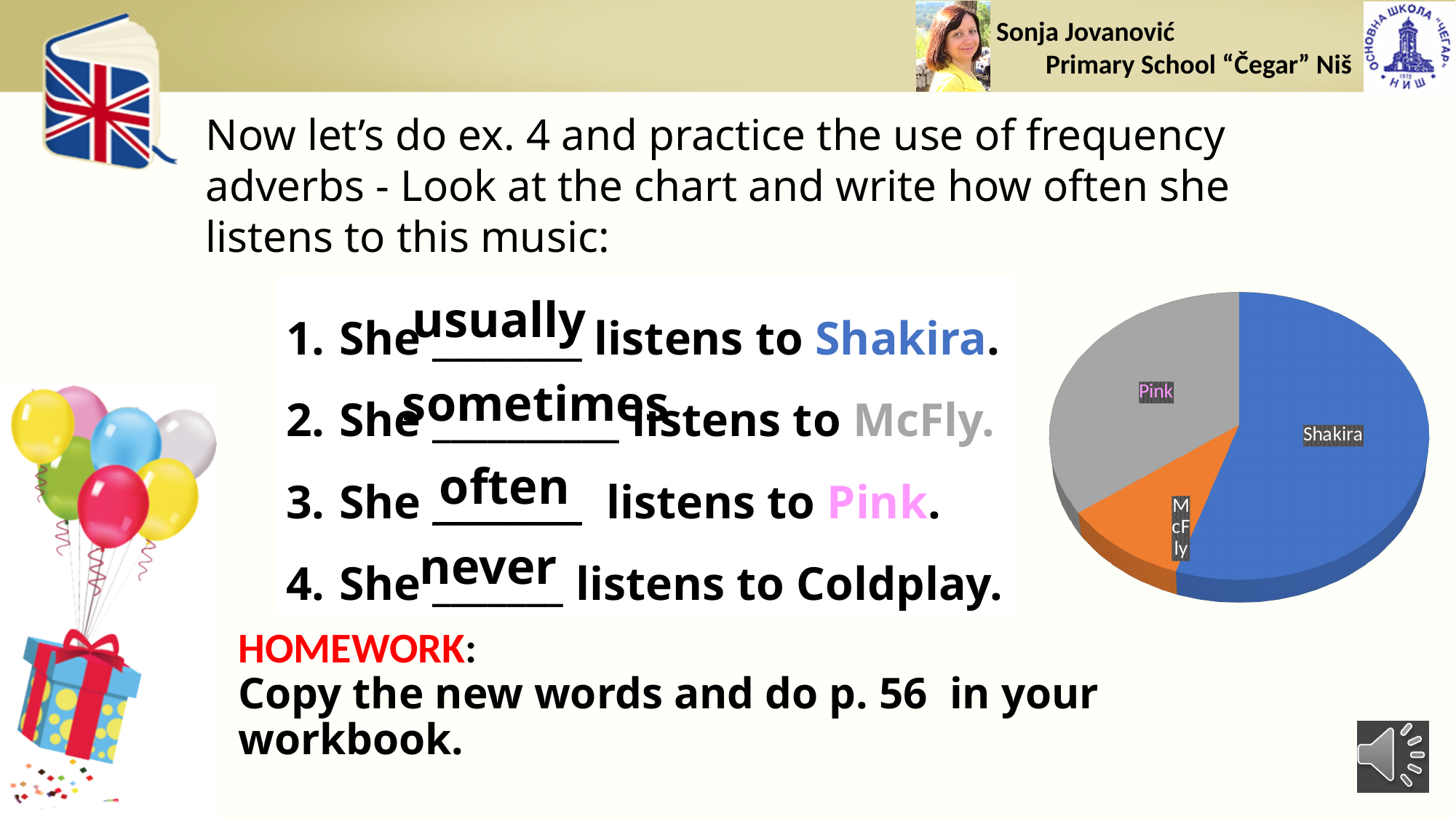
What colour is the Shakira slice in the pie chart? blue Which slice of the pie chart is the smallest? McFly What kind of chart is shown on the slide? pie chart Which slice of the pie chart is coloured orange? McFly Which slice is smaller in the pie chart, Shakira or McFly? McFly Which slice is larger in the pie chart, Pink or McFly? Pink Which slice of the pie chart is the largest? Shakira Which slice is larger in the pie chart, Shakira or Pink? Shakira How many slices does the pie chart have? 3